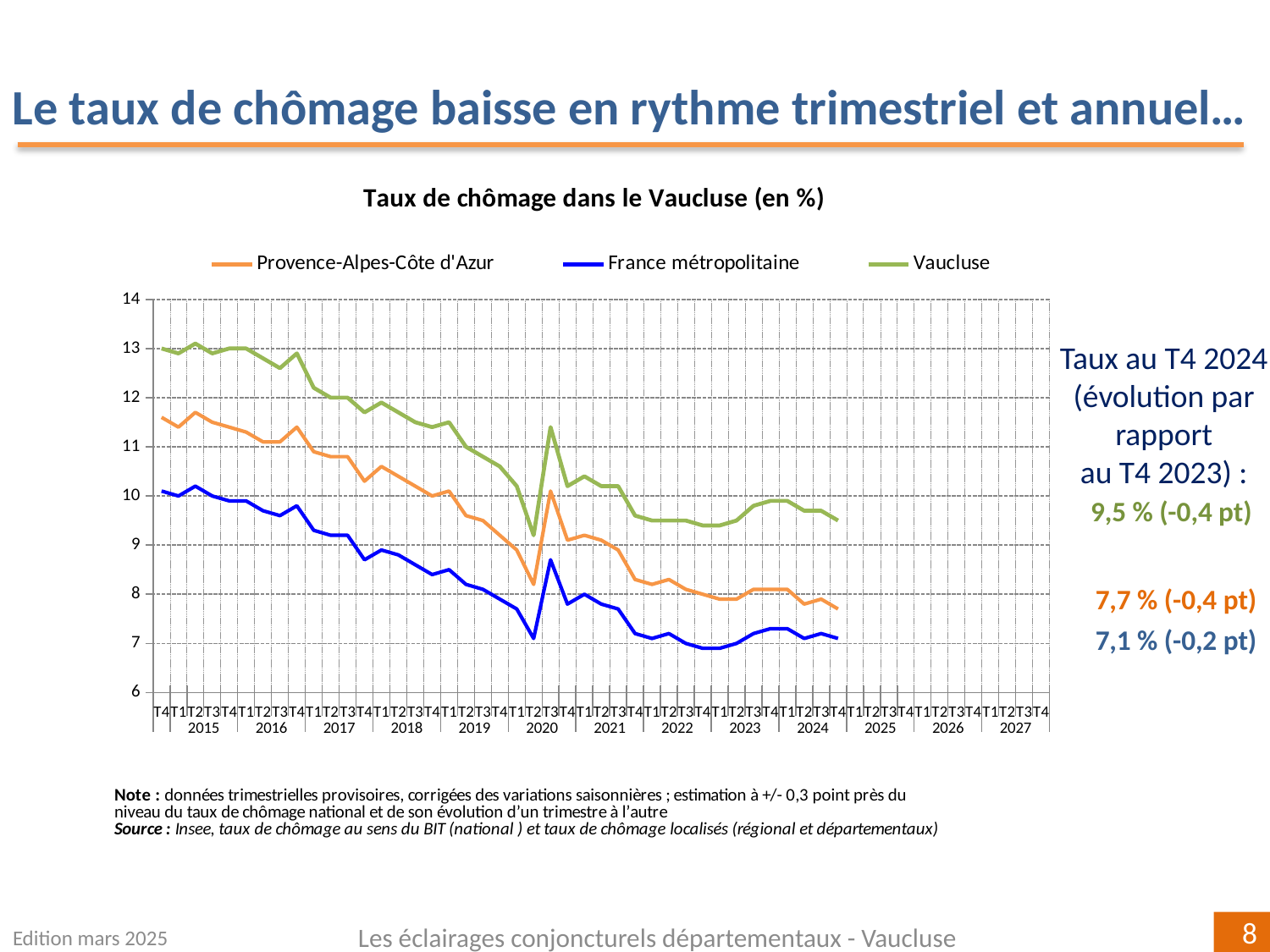
What is the difference between the Vaucluse rate and the France métropolitaine rate at T4 2024? 2,4 points Overall, do the unemployment rates rise or fall between 2015 and 2024? fall Which series has the lowest values across the whole period? France métropolitaine Which series has the highest values across the whole period? Vaucluse By how many points did the Vaucluse rate change between T4 2023 and T4 2024? -0,4 pt What is the unemployment rate for Vaucluse at T4 2024? 9,5 % What is the title of the chart? Taux de chômage dans le Vaucluse (en %) How many series does the legend list? 3 What kind of chart is shown on the slide? line chart What is the unemployment rate for France métropolitaine at T4 2024? 7,1 % Is the value for Vaucluse at T4 2014 greater or less than 12? greater What is the unemployment rate for Provence-Alpes-Côte d'Azur at T4 2024? 7,7 %